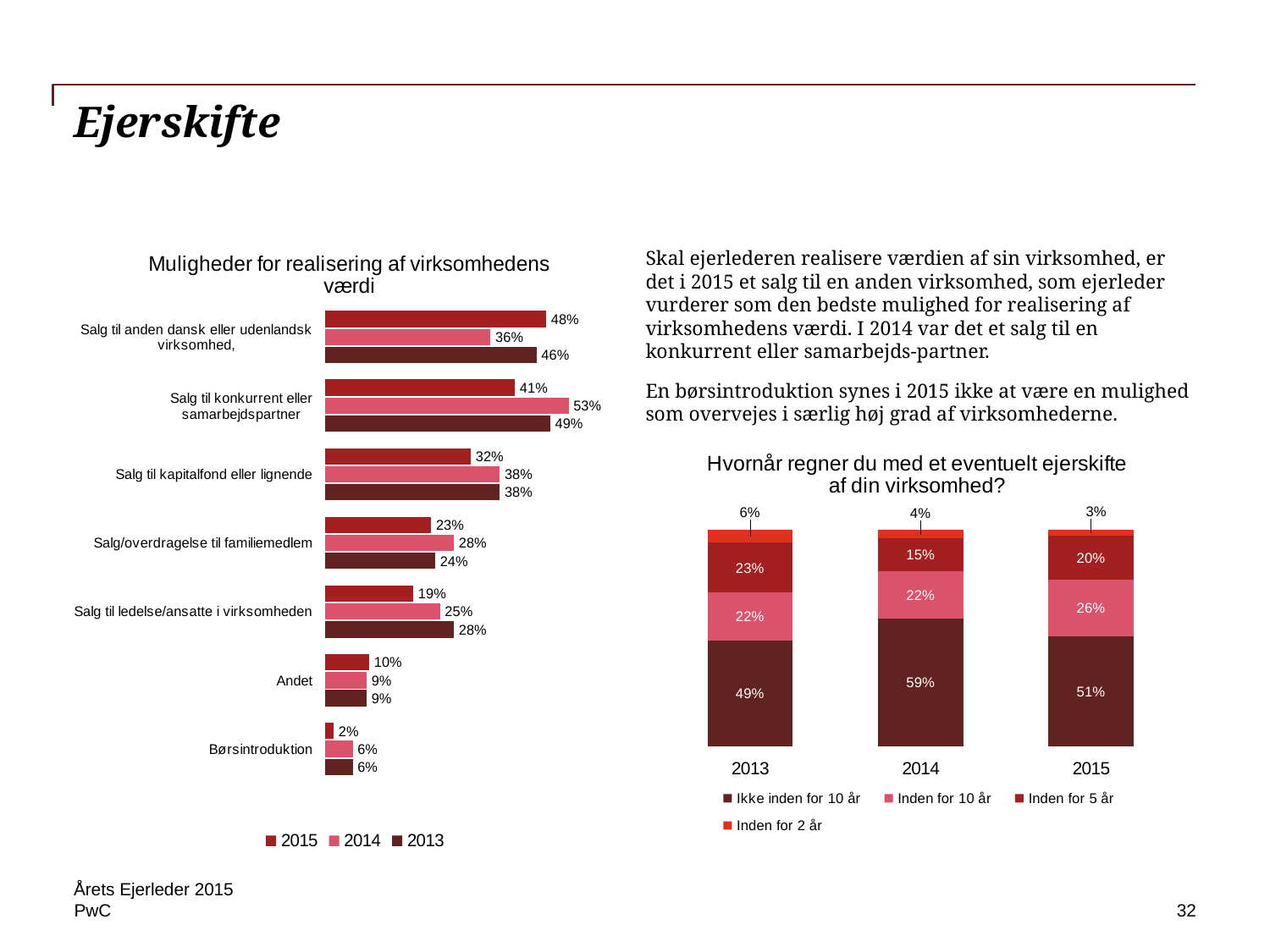
In the chart 'Muligheder for realisering af virksomhedens værdi', how many categories are shown? 7 In the chart 'Hvornår regner du med et eventuelt ejerskifte af din virksomhed?', what is the 'Inden for 2 år' value for 2015? 3% In the chart 'Hvornår regner du med et eventuelt ejerskifte af din virksomhed?', which year has the highest 'Inden for 5 år' value? 2013 In the chart 'Muligheder for realisering af virksomhedens værdi', what is the 2014 value for 'Salg til konkurrent eller samarbejdspartner'? 53% In the chart 'Hvornår regner du med et eventuelt ejerskifte af din virksomhed?', is the 'Inden for 10 år' value larger for 2015 or 2014? 2015 In the chart 'Muligheder for realisering af virksomhedens værdi', how many series does the legend list? 3 In the chart 'Hvornår regner du med et eventuelt ejerskifte af din virksomhed?', what is the 'Ikke inden for 10 år' value for 2014? 59% In the chart 'Muligheder for realisering af virksomhedens værdi', what is the 2015 value for 'Salg til anden dansk eller udenlandsk virksomhed'? 48% In the chart 'Muligheder for realisering af virksomhedens værdi', which category has the lowest 2015 value? Børsintroduktion In the chart 'Muligheder for realisering af virksomhedens værdi', which category has the highest 2014 value? Salg til konkurrent eller samarbejdspartner What kind of chart is 'Hvornår regner du med et eventuelt ejerskifte af din virksomhed?'? Stacked bar chart In the chart 'Muligheder for realisering af virksomhedens værdi', what is the difference between the 2014 and 2015 values for 'Salg til konkurrent eller samarbejdspartner'? 12%